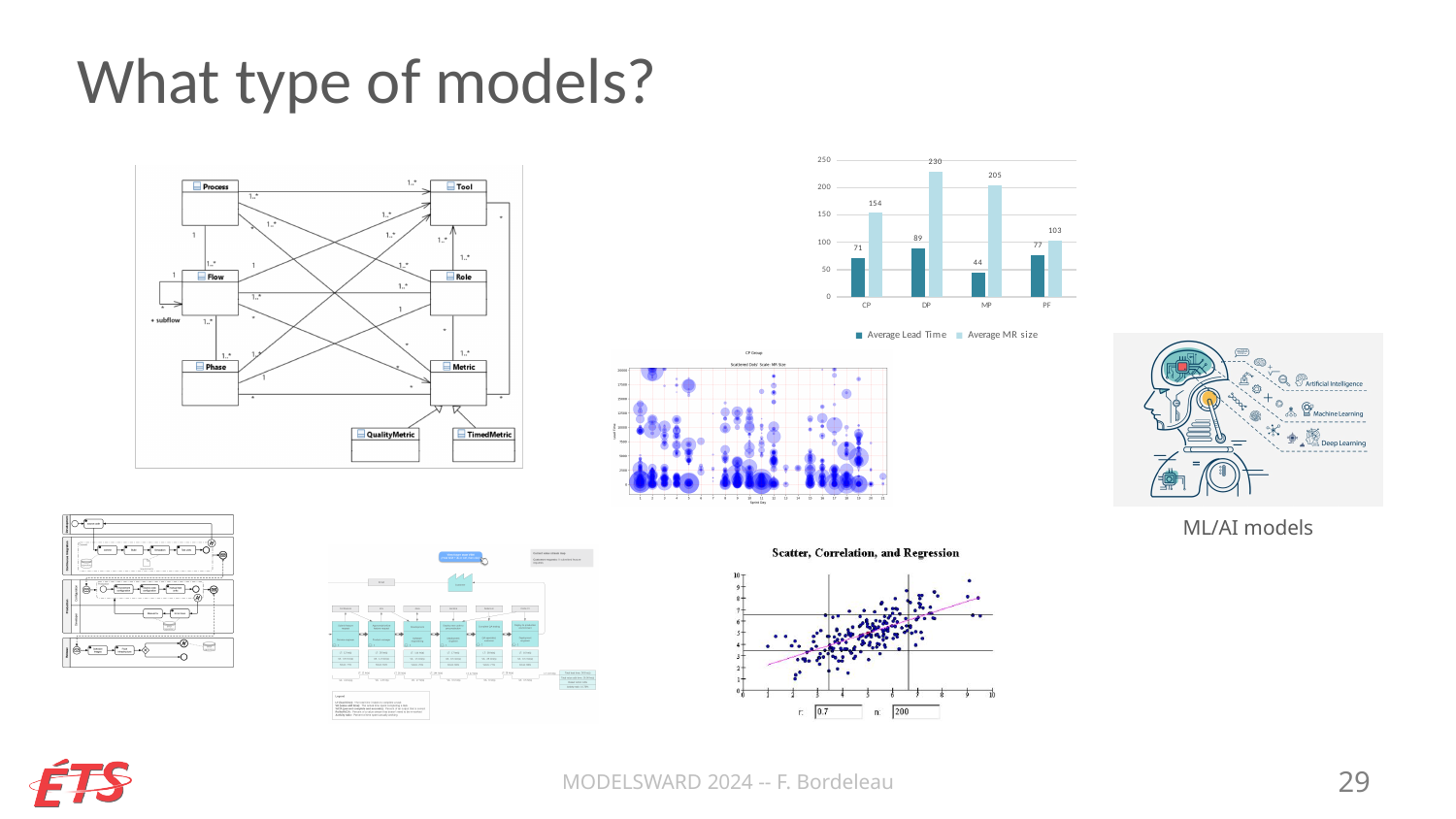
In the chart titled 'Scatter, Correlation, and Regression', what value of r is shown below the plot? 0.7 In the bar chart at the top right, what is the Average Lead Time for DP? 89 What type of chart is the chart at the top right of the slide? bar chart In the bar chart at the top right, what is the Average MR size for PF? 103 In the bar chart at the top right, which is larger: the Average Lead Time for PF or the Average Lead Time for CP? Average Lead Time for PF How many series does the legend of the bar chart at the top right list? 2 In the bar chart at the top right, what is the difference between the Average MR size and the Average Lead Time for CP? 83 In the bar chart at the top right, which category has the highest Average MR size? DP In the bar chart at the top right, what is the Average MR size for MP? 205 How many categories are shown on the x axis of the bar chart at the top right? 4 In the bar chart at the top right, which category has the lowest Average Lead Time? MP In the bar chart at the top right, is the Average MR size for DP greater or less than 200? greater